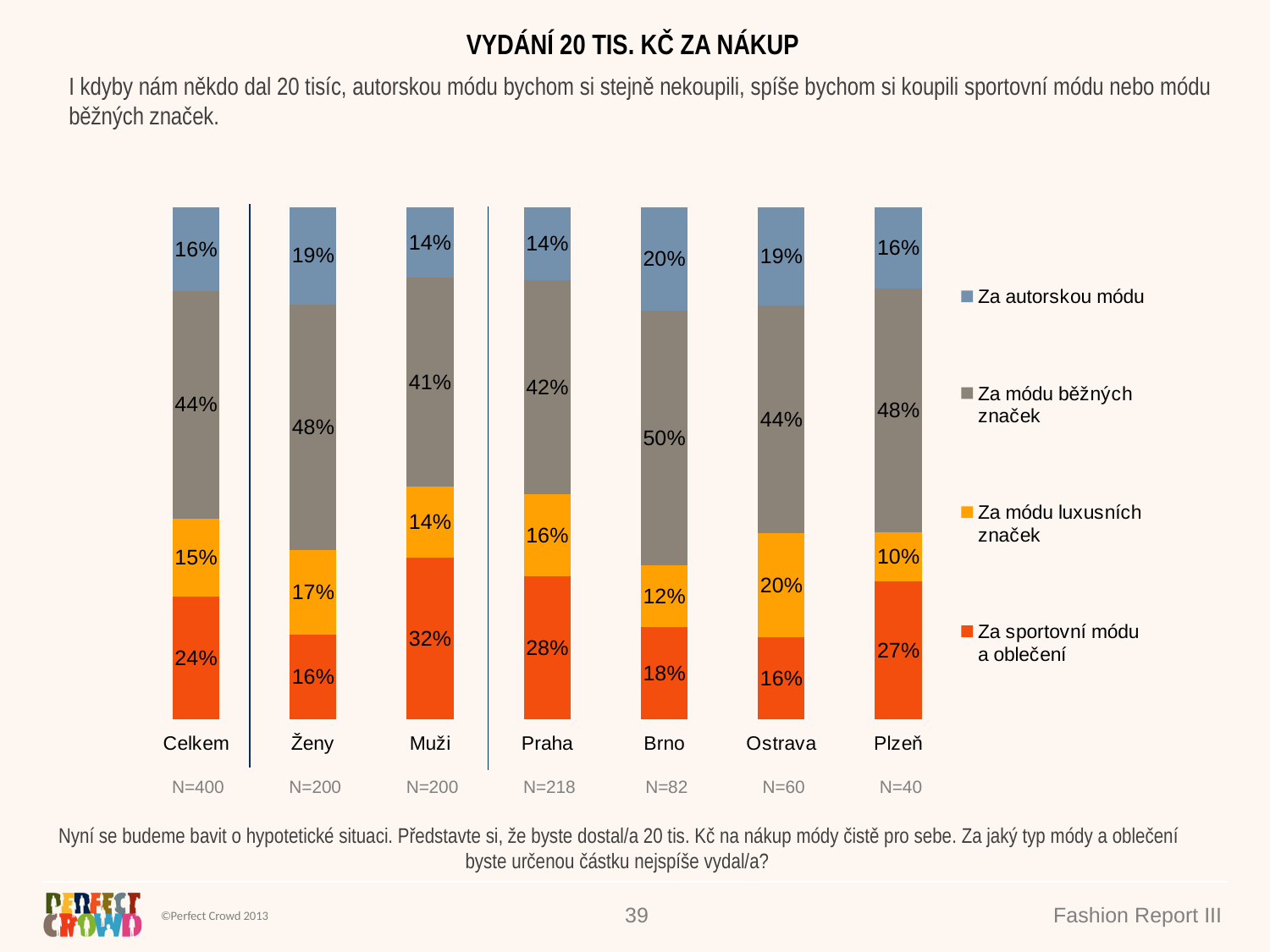
How many categories are shown on the x axis of the chart? 7 Which is larger: the 'Za sportovní módu a oblečení' value for Praha or for Brno? Praha What is the value for 'Za módu běžných značek' in the Brno bar? 50% What share of the Ostrava bar is 'Za módu luxusních značek'? 20% Which category has the lowest value for 'Za módu luxusních značek'? Plzeň Which category has the highest value for 'Za sportovní módu a oblečení'? Muži What is the value for 'Za autorskou módu' for Ženy? 19% How many series does the legend list? 4 What is the sample size (N) shown under the Plzeň bar? N=40 What percentage of the Celkem bar is for 'Za sportovní módu a oblečení'? 24% What is the difference between the 'Za módu běžných značek' values for Brno and Muži? 9% What kind of chart is shown on the slide? Stacked bar chart